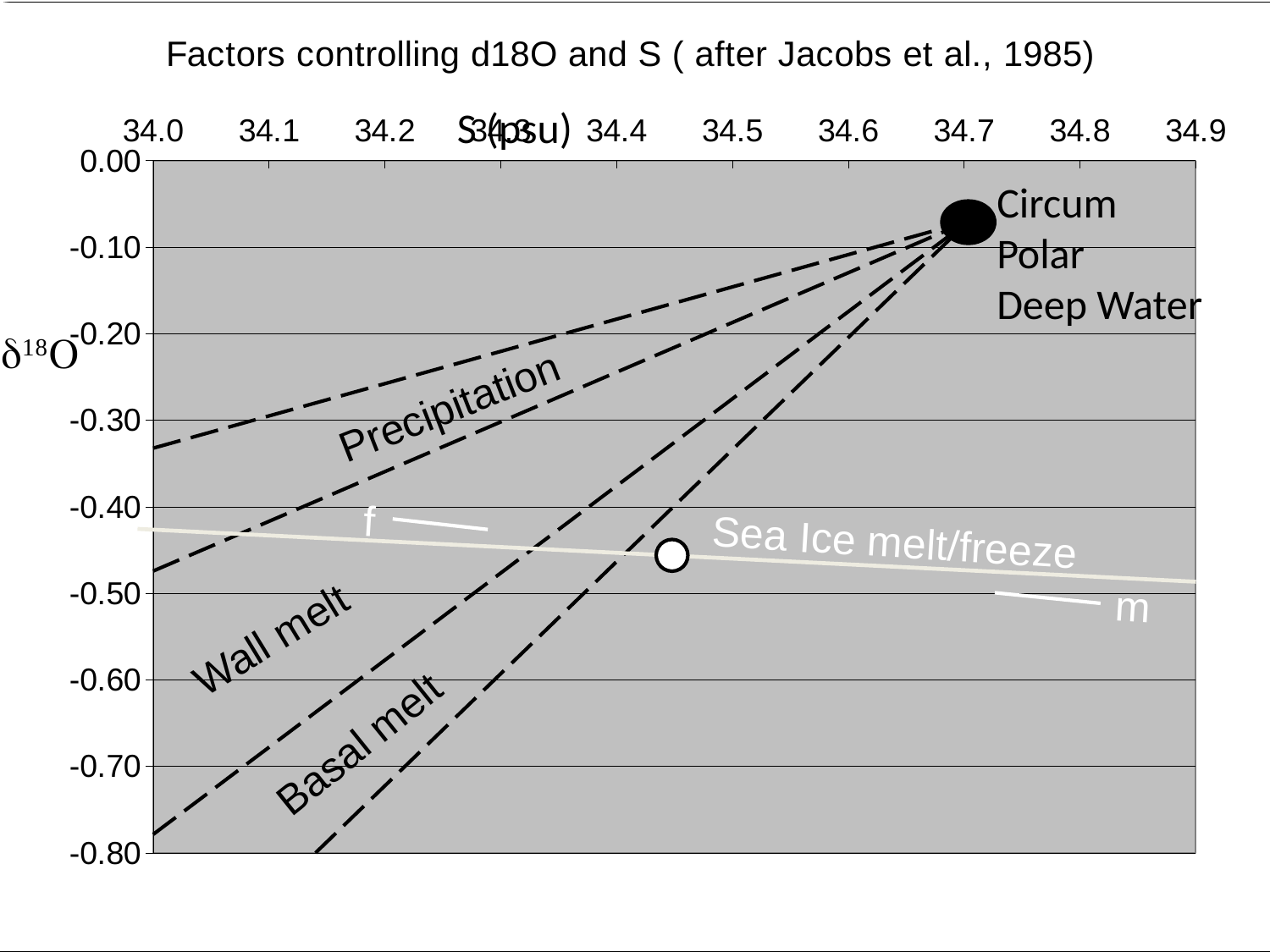
How many labeled process lines (Precipitation, Wall melt, Basal melt, Sea Ice melt/freeze) are drawn on the chart? 4 How many tick labels are shown on the horizontal (S) axis? 10 Does the Precipitation line rise or fall as S increases from 34.0 to 34.7? rise Does the Sea Ice melt/freeze line rise or fall as S increases from left to right? fall What kind of chart is shown on the slide? line chart What is the label on the vertical axis of the chart? δ18O At S = 34.0, which line has the higher δ18O value, Precipitation or Wall melt? Precipitation Which labeled line reaches the bottom of the plot at δ18O = -0.80? Basal melt What is the title of the chart? Factors controlling d18O and S ( after Jacobs et al., 1985) Is the δ18O value of the Circum Polar Deep Water point greater or less than -0.10? greater